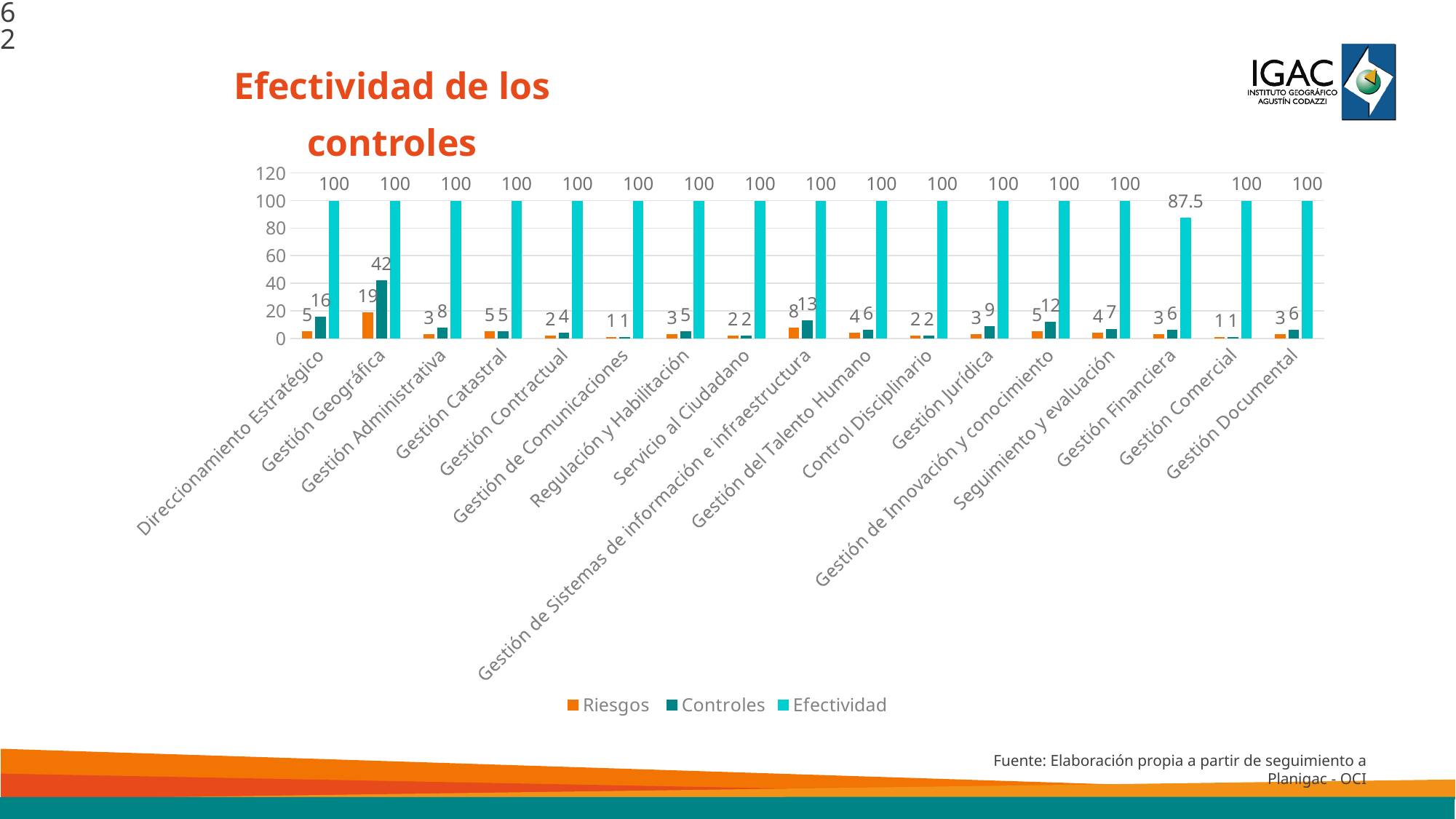
What is the Controles value for Gestión Geográfica? 42 Which series is shown in orange? Riesgos What is the Riesgos value for Gestión de Sistemas de información e infraestructura? 8 What is the Efectividad value for Gestión Financiera? 87.5 Which is larger: the Controles value for Gestión Jurídica or the Controles value for Gestión de Innovación y conocimiento? Gestión de Innovación y conocimiento What is the title of the chart? Efectividad de los controles Which category has the lowest Efectividad value? Gestión Financiera How many categories are shown on the x axis? 17 How many series does the legend list? 3 Which category has the highest Riesgos value? Gestión Geográfica What is the difference between the Controles and Riesgos values for Gestión Geográfica? 23 What kind of chart is shown on the slide? bar chart